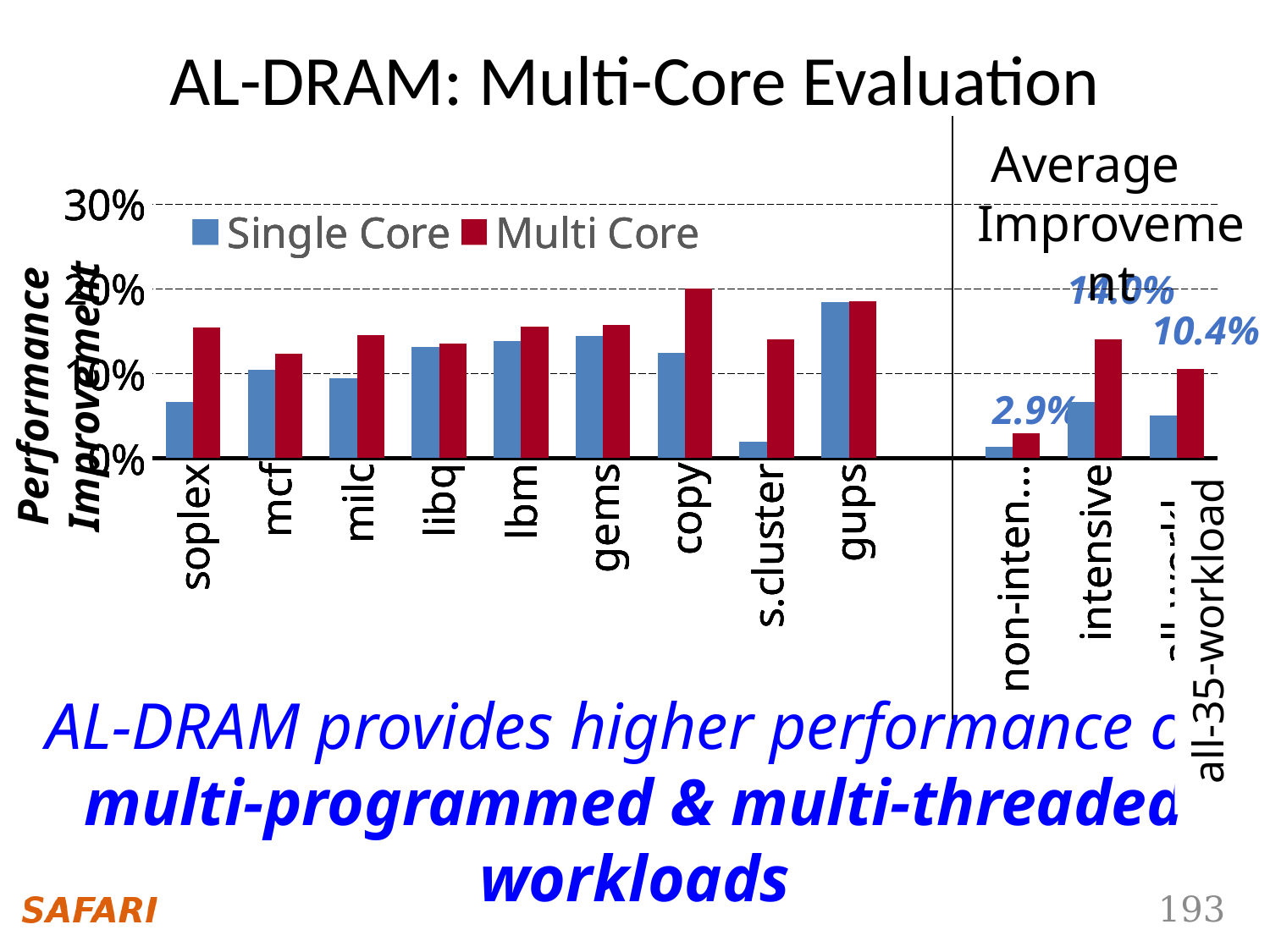
What are the two series named in the chart legend? Single Core and Multi Core What is the title of the slide containing the chart? AL-DRAM: Multi-Core Evaluation Is the Single Core value for s.cluster greater or less than 10%? less Is the Multi Core value for soplex greater or less than 10%? greater What data label is printed above the bars for the non-inten… category? 2.9% How many categories are shown along the x axis of the chart? 12 How many series does the chart legend list? 2 Among the nine benchmarks left of the divider line, which has the lowest Single Core bar? s.cluster Which category has the highest Single Core bar? gups What data label is printed above the bars for the all-35-workload category? 10.4% What kind of chart is shown on the slide? bar chart For soplex, which is larger: the Single Core value or the Multi Core value? Multi Core